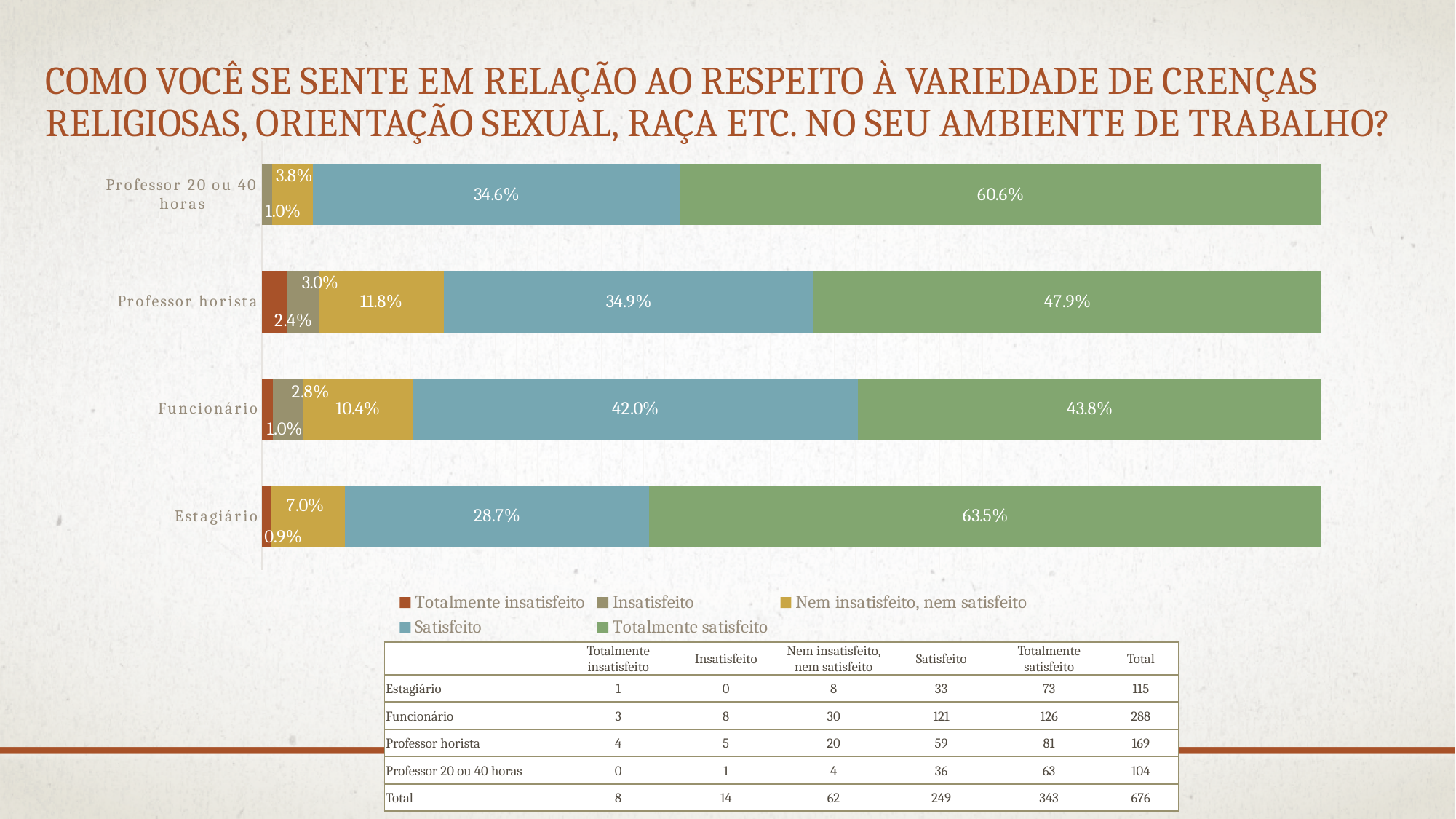
Which category has the lowest 'Satisfeito' share? Estagiário Which category has the highest 'Totalmente satisfeito' share? Estagiário What is the difference between the 'Totalmente satisfeito' and 'Satisfeito' values for Funcionário? 1.8 percentage points How many categories (job groups) are plotted in the chart? 4 What is the 'Nem insatisfeito, nem satisfeito' value for Professor horista? 11.8% What is the 'Totalmente satisfeito' value for Estagiário? 63.5% What is the 'Totalmente satisfeito' value for Professor 20 ou 40 horas? 60.6% Which colour represents 'Totalmente satisfeito' in the chart legend? Green What is the 'Satisfeito' value for Funcionário? 42.0% What type of chart is shown on the slide? Stacked bar chart How many series does the chart legend list? 5 Which is larger for Professor horista: the 'Satisfeito' value or the 'Totalmente satisfeito' value? Totalmente satisfeito (47.9%)